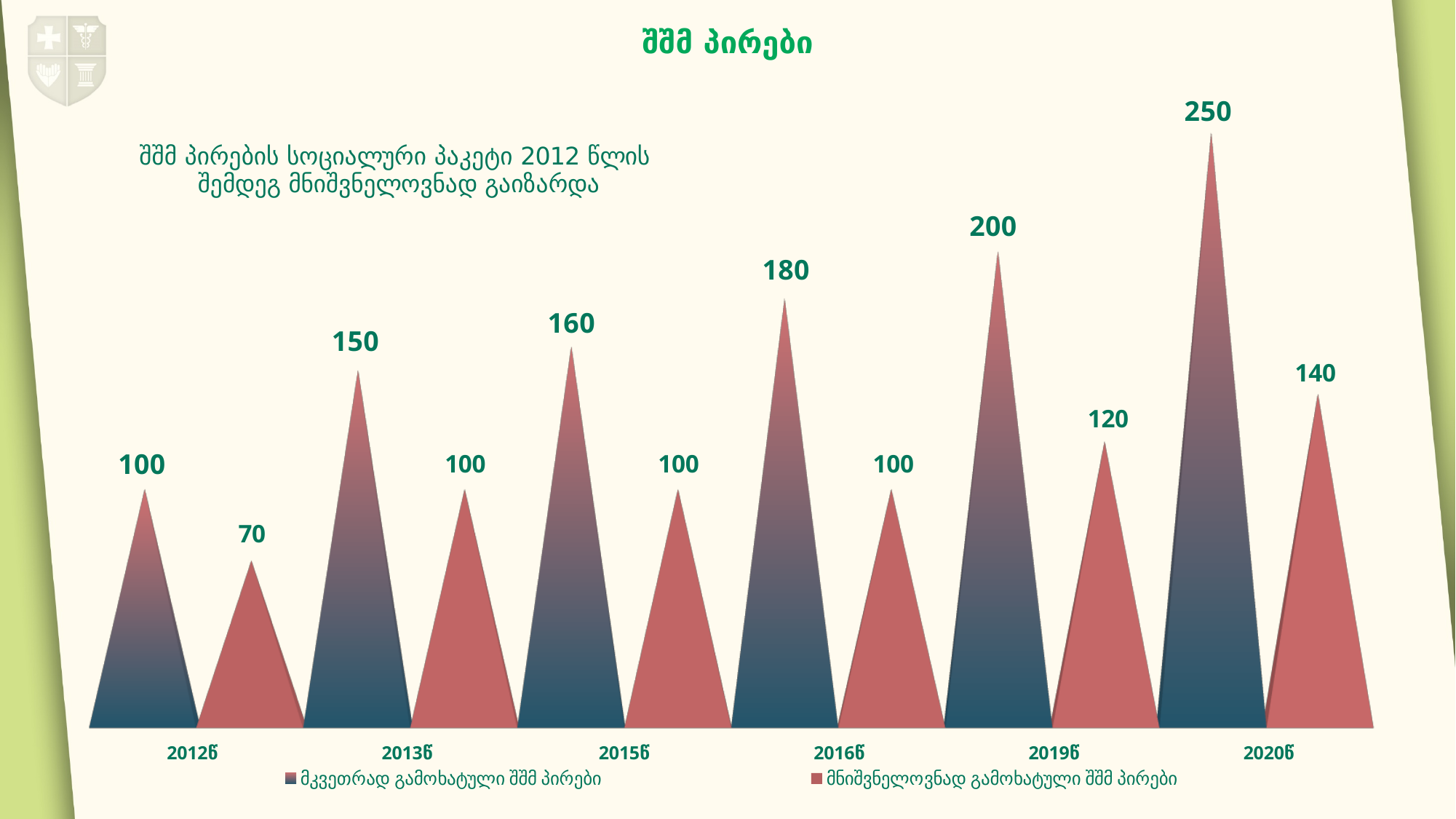
What is the value for მკვეთრად გამოხატული შშმ პირები in 2012წ? 100 In which year is the value for მკვეთრად გამოხატული შშმ პირები highest? 2020წ In which year is the value for მნიშვნელოვნად გამოხატული შშმ პირები lowest? 2012წ How many years are shown on the x axis? 6 What is the value for მნიშვნელოვნად გამოხატული შშმ პირები in 2012წ? 70 What is the title of the chart? შშმ პირების სოციალური პაკეტი 2012 წლის შემდეგ მნიშვნელოვნად გაიზარდა Which is larger in 2016წ: მკვეთრად გამოხატული შშმ პირები or მნიშვნელოვნად გამოხატული შშმ პირები? მკვეთრად გამოხატული შშმ პირები Does the value for მკვეთრად გამოხატული შშმ პირები rise or fall from 2012წ to 2020წ? rise What is the difference between the two series' values in 2020წ? 110 How many series does the legend list? 2 What is the value for მკვეთრად გამოხატული შშმ პირები in 2020წ? 250 What is the value for მნიშვნელოვნად გამოხატული შშმ პირები in 2019წ? 120